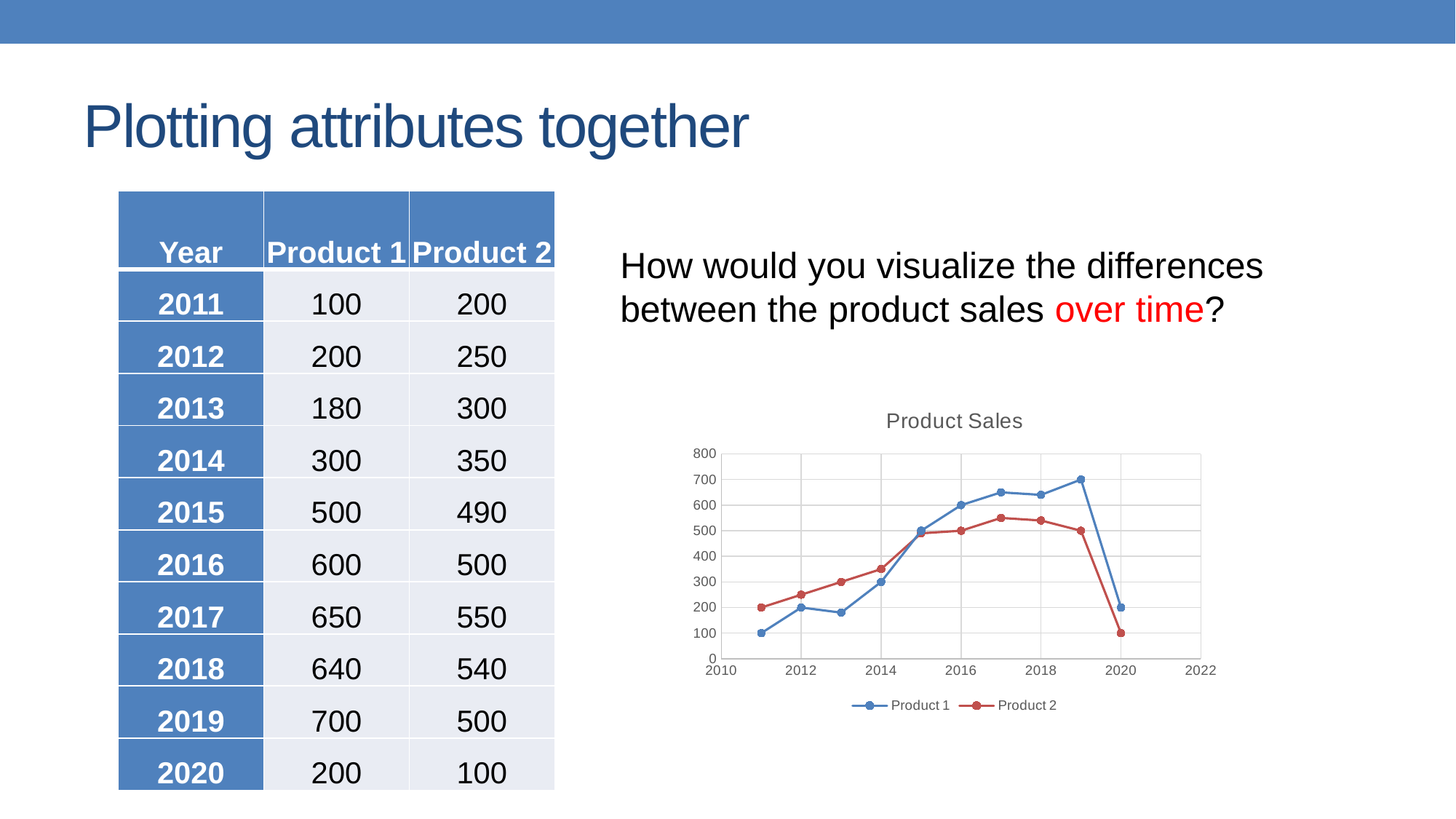
In the Product Sales chart, is the value for Product 1 in 2016 greater or less than 500? greater In the Product Sales chart, what is the difference between Product 1 and Product 2 in 2019? 200 How many years are plotted for each series in the Product Sales chart? 10 What is the title of the chart on the slide? Product Sales How many series does the legend of the Product Sales chart list? 2 In the Product Sales chart, what is the value for Product 1 in 2019? 700 In the Product Sales chart, in which year does Product 1 reach its highest value? 2019 In the Product Sales chart, what is the value for Product 1 in 2011? 100 What kind of chart is the Product Sales chart? line chart In the Product Sales chart, in which year does Product 2 have its lowest value? 2020 In the Product Sales chart, what is the value for Product 2 in 2017? 550 In the Product Sales chart, which series has the larger value in 2013, Product 1 or Product 2? Product 2